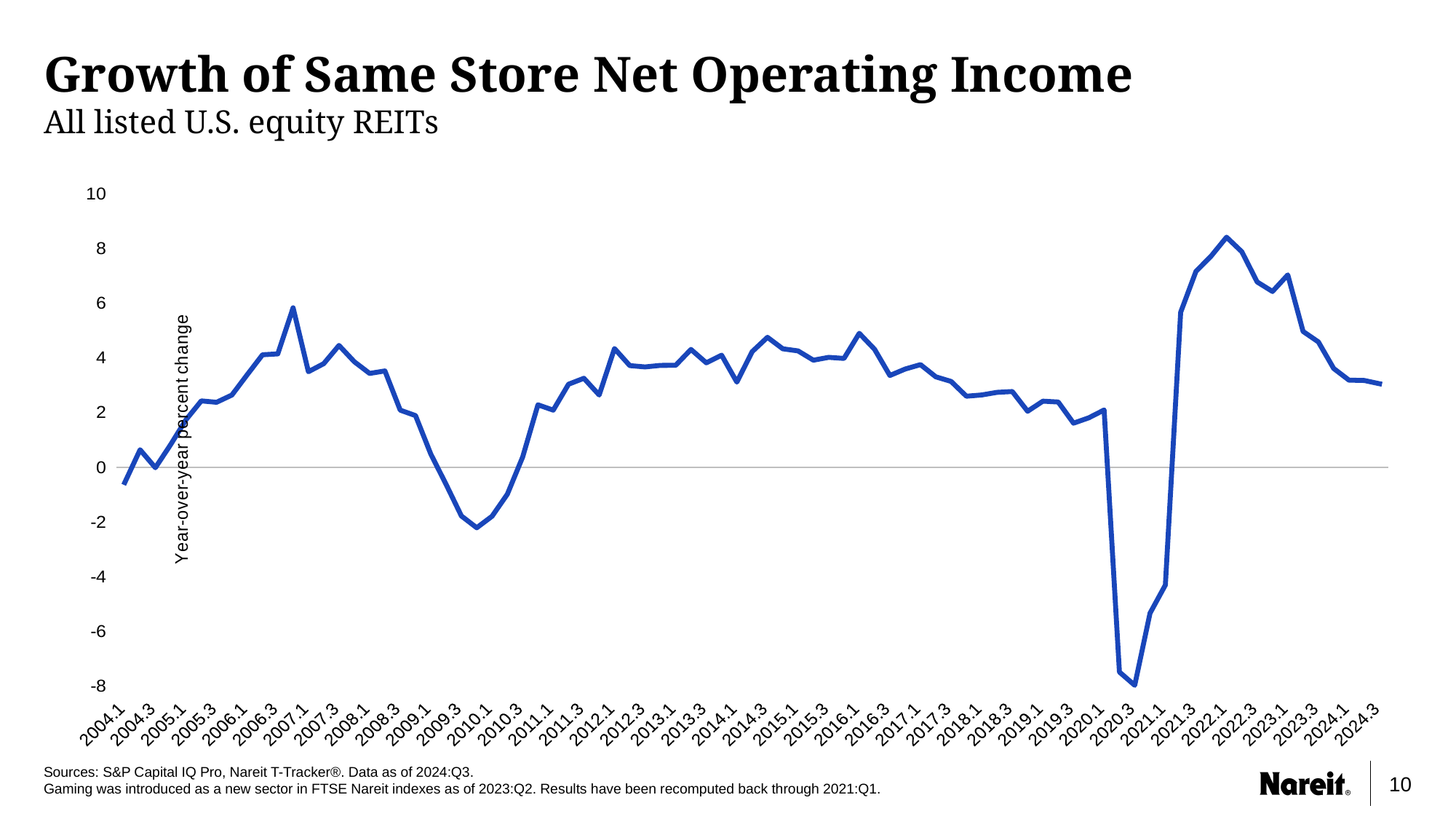
Is the value for 2010.1 greater or less than 0? less Which quarter on the x axis has the highest value on the line? 2022.1 Is the value for 2022.1 greater or less than 6? greater Does the line rise or fall between 2022.1 and 2024.3? fall What is the label on the y axis of the chart? Year-over-year percent change In which year does the line reach its lowest point? 2020 Is the value for 2024.3 greater or less than 4? less What kind of chart is shown on the slide? line chart Which is larger, the value for 2007.1 or the value for 2010.1? 2007.1 Does the line rise or fall between 2020.3 and 2021.3? rise What is the title of the chart on the slide? Growth of Same Store Net Operating Income